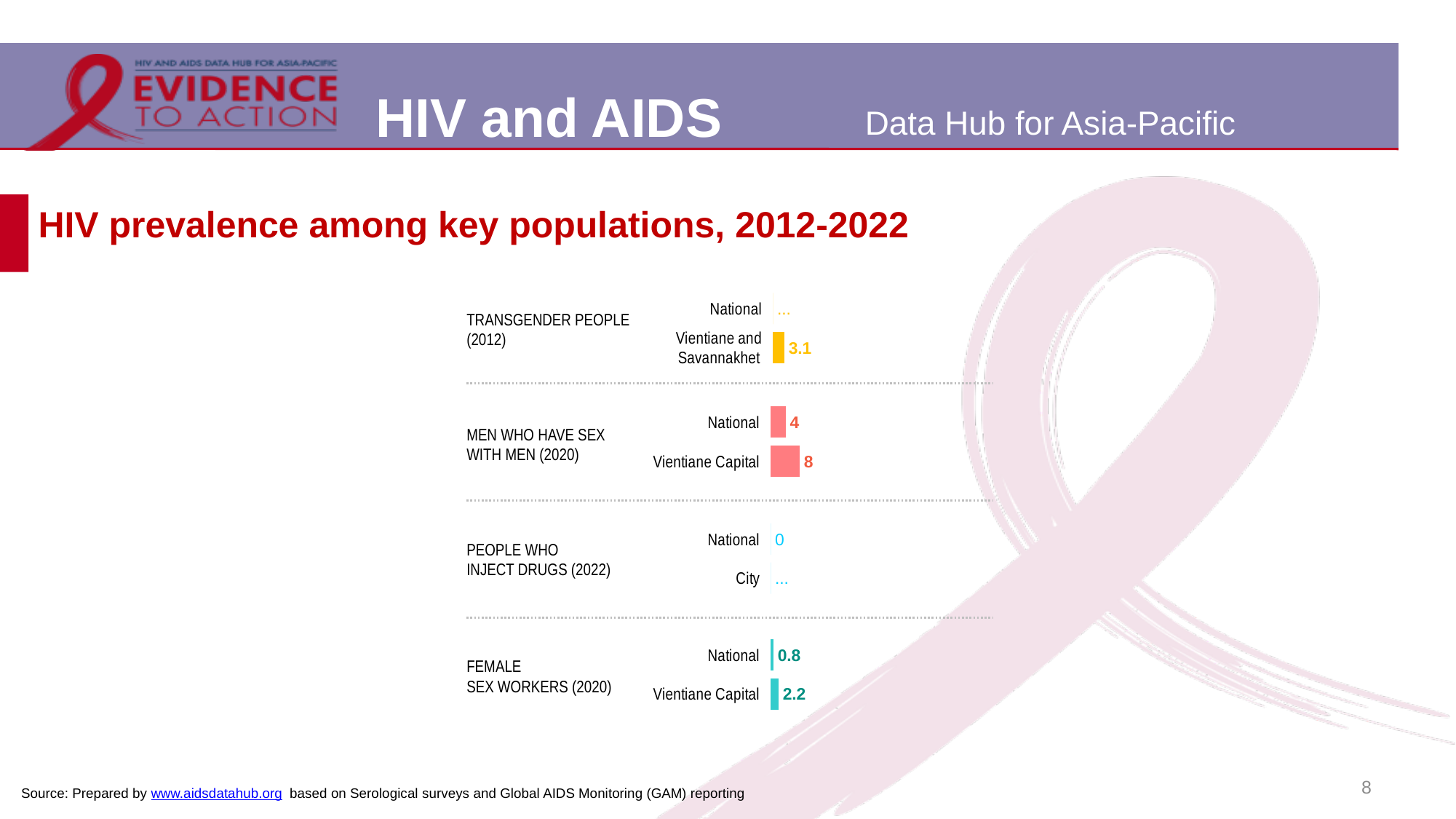
What is the HIV prevalence value shown for men who have sex with men (2020) in Vientiane Capital? 8 Which is larger: the Vientiane and Savannakhet value for transgender people (2012) or the Vientiane Capital value for female sex workers (2020)? Vientiane and Savannakhet value for transgender people (2012) How many key population groups are shown on the chart? 4 What is the HIV prevalence value shown for people who inject drugs (2022) at the national level? 0 What type of chart is shown on the slide? Bar chart What is the difference between the Vientiane Capital and national values for men who have sex with men (2020)? 4 What is the HIV prevalence value shown for female sex workers (2020) at the national level? 0.8 What is the HIV prevalence value shown for transgender people (2012) in Vientiane and Savannakhet? 3.1 What is the HIV prevalence value shown for men who have sex with men (2020) at the national level? 4 What is the difference between the Vientiane Capital and national values for female sex workers (2020)? 1.4 What is the HIV prevalence value shown for female sex workers (2020) in Vientiane Capital? 2.2 Which bar has the highest value on the chart? Men who have sex with men (2020), Vientiane Capital